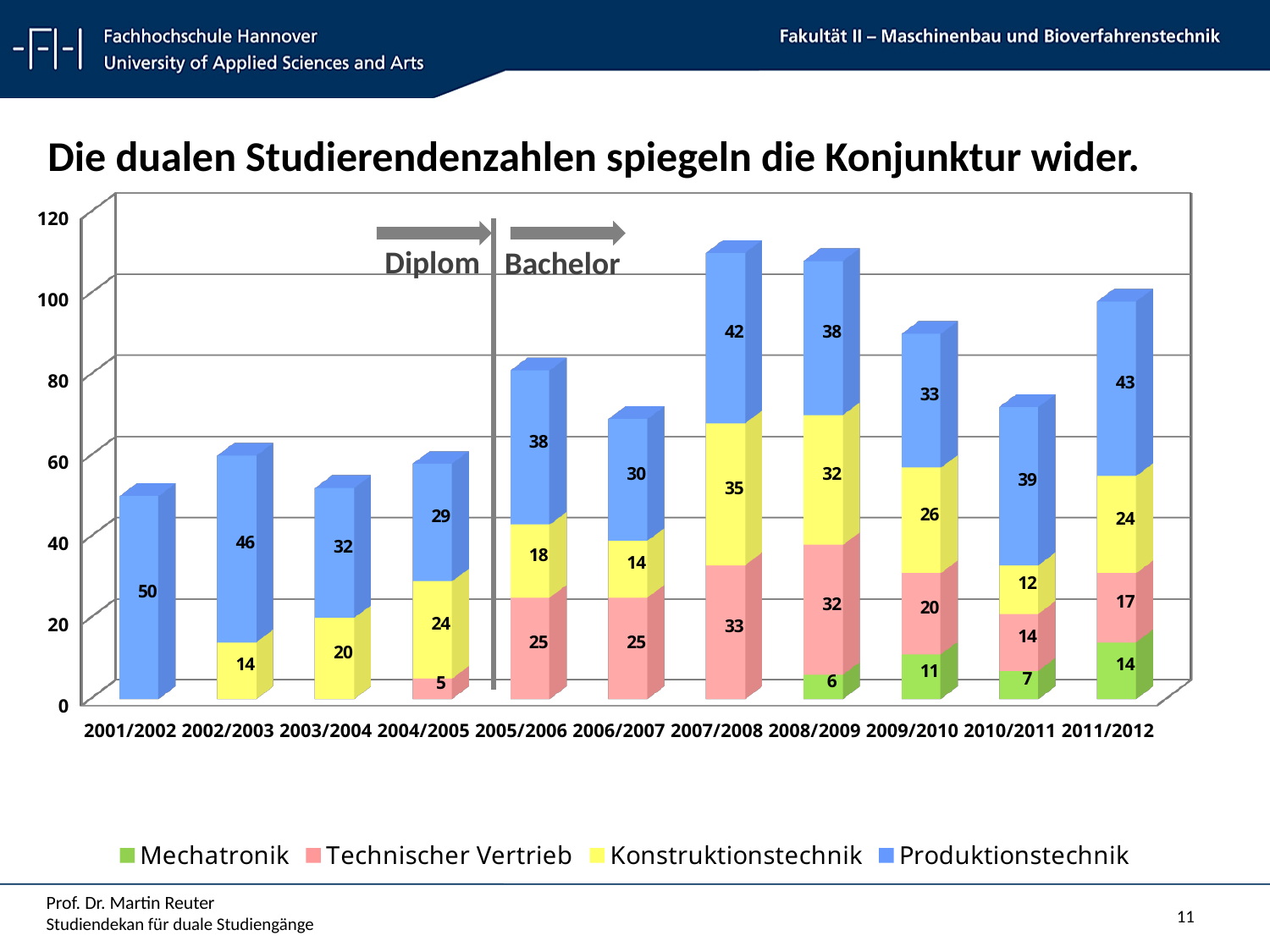
What is the Konstruktionstechnik value for 2007/2008? 35 What is the Technischer Vertrieb value for 2004/2005? 5 What is the Mechatronik value for 2009/2010? 11 In which year is the Produktionstechnik value highest? 2001/2002 Which is larger, the Konstruktionstechnik value for 2005/2006 or for 2006/2007? 2005/2006 In which year is the Mechatronik value lowest among the years where it is shown? 2008/2009 What is the difference between the Produktionstechnik values for 2011/2012 and 2010/2011? 4 What is the Produktionstechnik value for 2001/2002? 50 What kind of chart is shown on the slide? Stacked bar chart How many series does the legend list? 4 How many years are shown on the x axis? 11 What is the total of the stacked bar for 2007/2008? 110